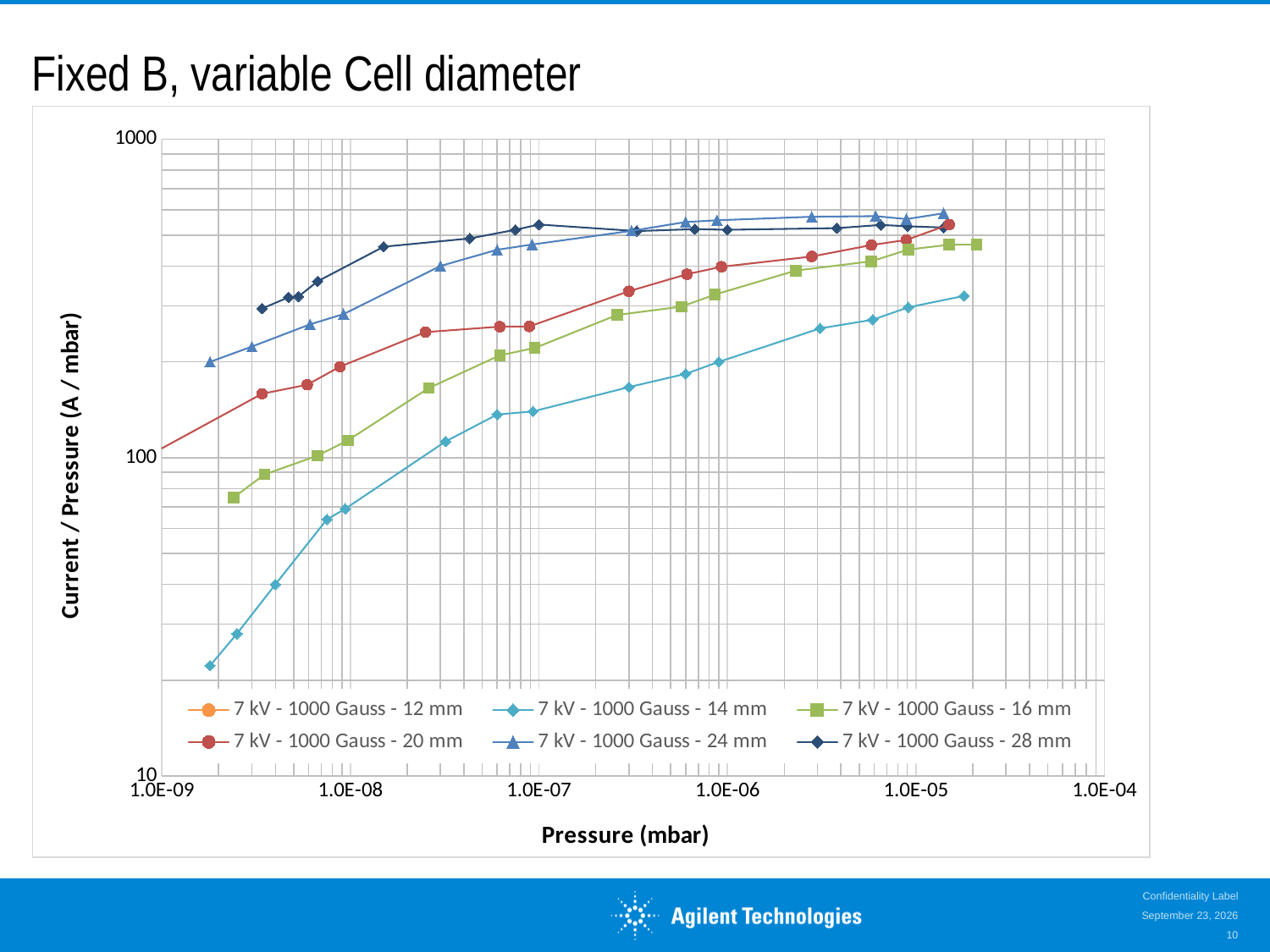
At 1.0E-06 mbar, which series has the larger value: 7 kV - 1000 Gauss - 16 mm or 7 kV - 1000 Gauss - 14 mm? 7 kV - 1000 Gauss - 16 mm Which series has the lowest value at 1.0E-08 mbar? 7 kV - 1000 Gauss - 14 mm How many series does the legend list? 6 Is the value for the 7 kV - 1000 Gauss - 14 mm series at its lowest pressure point greater or less than 100? less Which series has the highest value at 1.0E-08 mbar? 7 kV - 1000 Gauss - 28 mm Is the value for the 7 kV - 1000 Gauss - 28 mm series at 1.0E-08 mbar greater or less than 100? greater What is the label of the x axis? Pressure (mbar) What is the title of the slide containing the chart? Fixed B, variable Cell diameter What kind of chart is shown on the slide? Line chart Does the 7 kV - 1000 Gauss - 14 mm series rise or fall as pressure increases along the x axis? Rise Is the value for the 7 kV - 1000 Gauss - 24 mm series at 1.0E-05 mbar greater or less than 100? greater At 1.0E-07 mbar, which series has the larger value: 7 kV - 1000 Gauss - 24 mm or 7 kV - 1000 Gauss - 14 mm? 7 kV - 1000 Gauss - 24 mm